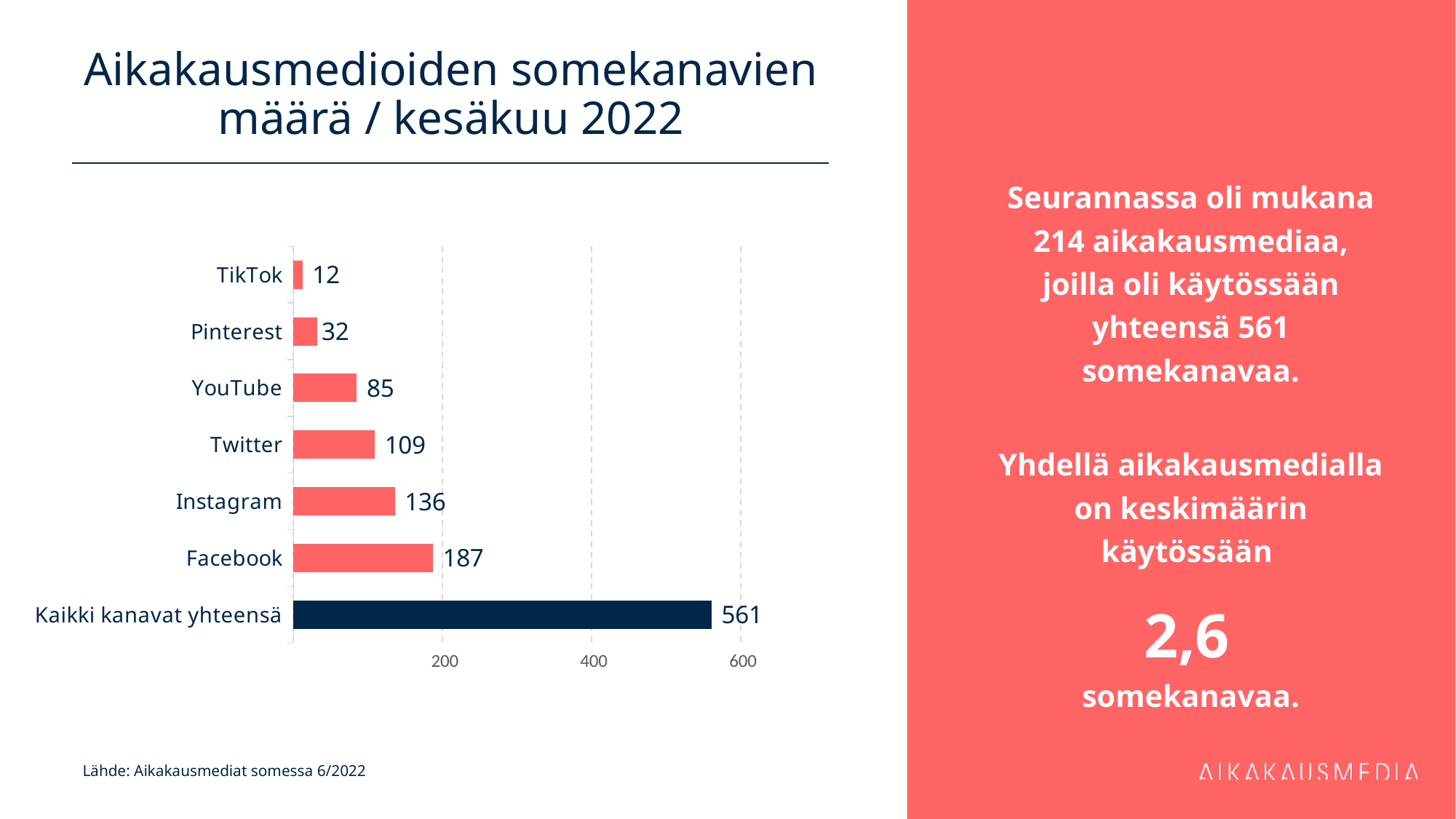
What is the value for Facebook? 187 What is the title of the chart? Aikakausmedioiden somekanavien määrä / kesäkuu 2022 What is the difference between the values for Twitter and YouTube? 24 What is the value for Instagram? 136 What is the value for TikTok? 12 What kind of chart is shown on the slide? Bar chart How many categories are shown on the chart? 7 Which individual social media channel has the highest value? Facebook What is the difference between the values for Facebook and Instagram? 51 Which is larger, the value for Pinterest or the value for YouTube? YouTube Which category has the lowest value? TikTok What is the value for Kaikki kanavat yhteensä? 561